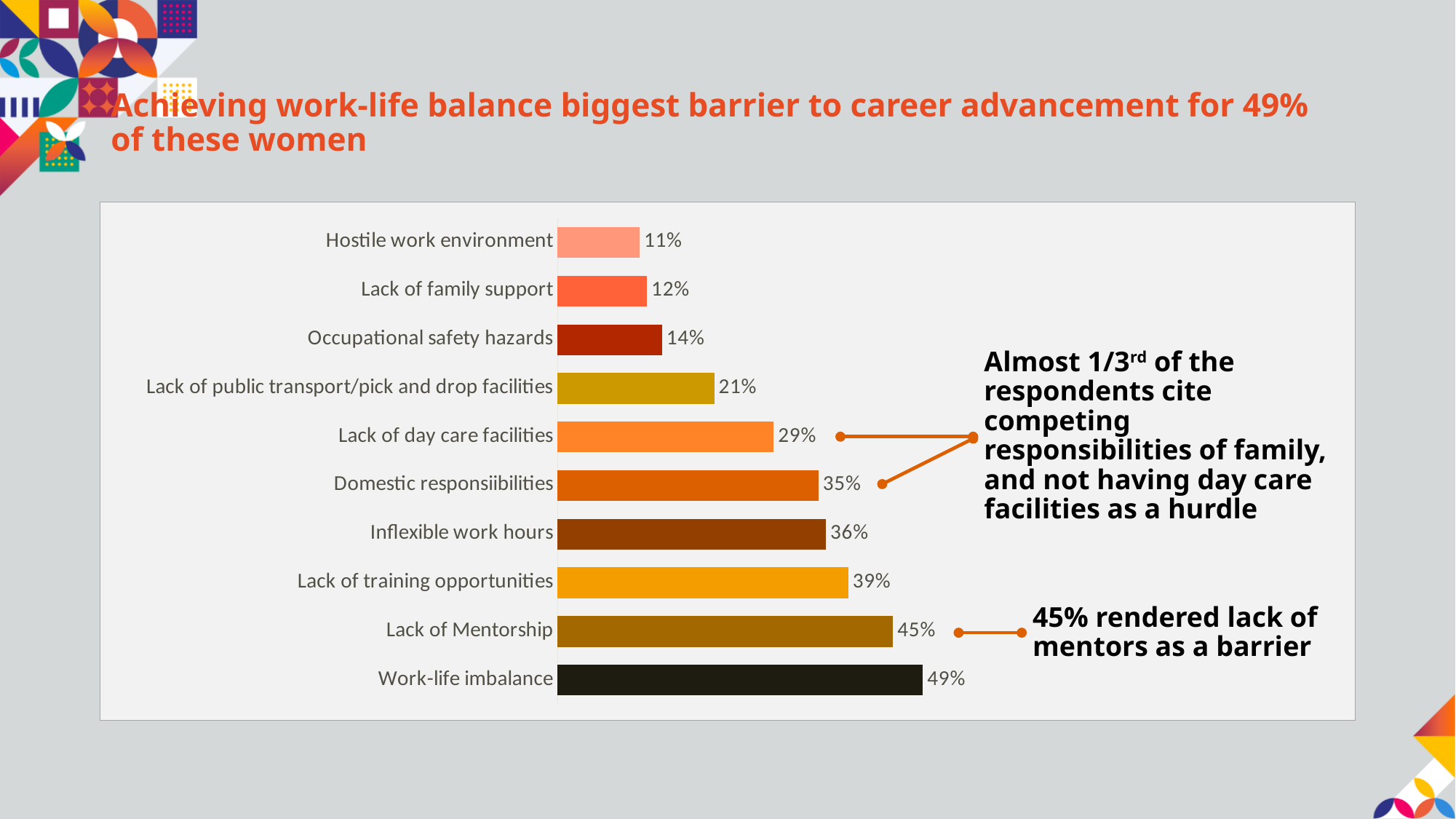
What is the difference between the values for Work-life imbalance and Lack of Mentorship? 4% Which barrier has the highest percentage? Work-life imbalance What is the difference between the values for Lack of training opportunities and Lack of day care facilities? 10% What percentage of respondents cited Work-life imbalance as a barrier? 49% What colour is the bar for Work-life imbalance? Black What is the value for Lack of public transport/pick and drop facilities? 21% What kind of chart is shown on the slide? Bar chart What is the value for Hostile work environment? 11% Which barrier has the lowest percentage? Hostile work environment What is the value for Lack of Mentorship? 45% How many barriers (categories) are shown in the chart? 10 Which is larger, the value for Domestic responsiibilities or the value for Lack of family support? Domestic responsiibilities